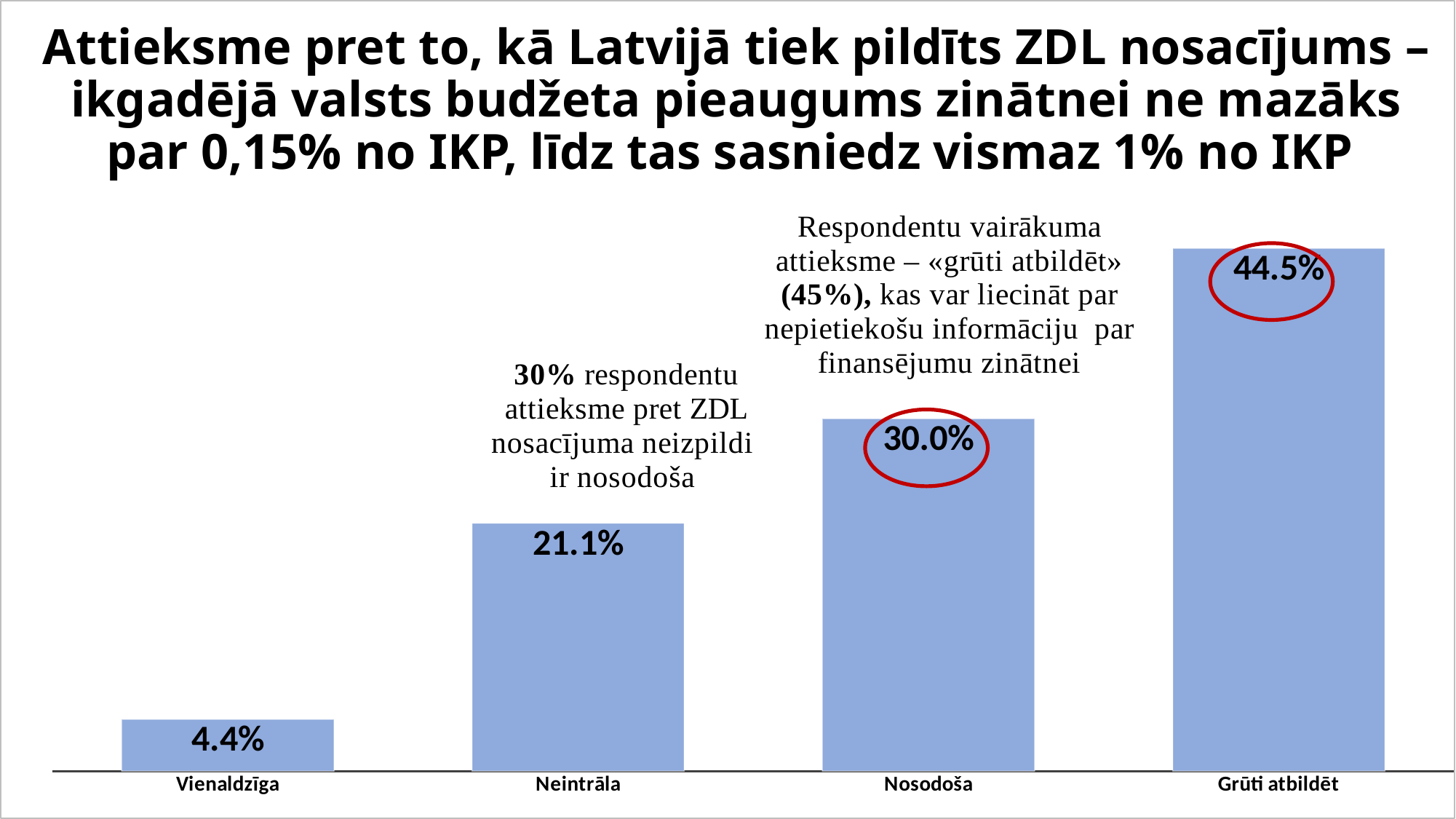
What is the difference between the values for Grūti atbildēt and Nosodoša? 14.5% How many categories are shown in the chart? 4 Do the values rise or fall from left to right along the x axis? Rise What is the value for Nosodoša? 30.0% What is the difference between the values for Neintrāla and Vienaldzīga? 16.7% Which category has the highest value? Grūti atbildēt What is the value for Grūti atbildēt? 44.5% Which category has the lowest value? Vienaldzīga What kind of chart is shown on the slide? Bar chart What is the value for Vienaldzīga? 4.4% Which is larger, the value for Nosodoša or the value for Neintrāla? Nosodoša What is the value for Neintrāla? 21.1%